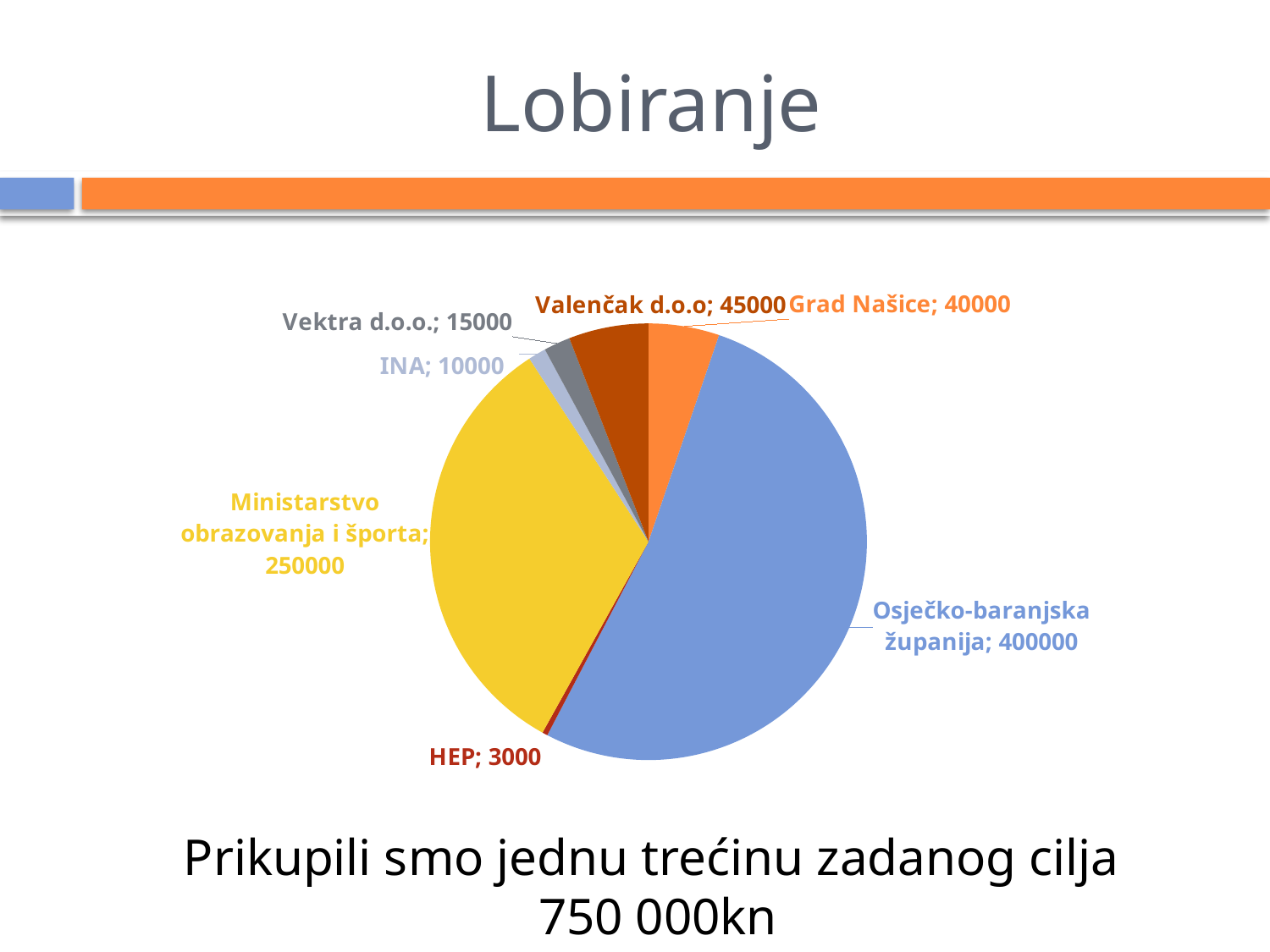
Which category has the largest slice of the pie? Osječko-baranjska županija What is the value for Valenčak d.o.o? 45000 What is the value for Ministarstvo obrazovanja i športa? 250000 How many slices does the pie chart have? 7 Which category has the smallest slice of the pie? HEP What is the sum of all the values shown in the pie chart? 763000 What kind of chart is shown on the slide? pie chart What is the value for Osječko-baranjska županija? 400000 What colour is the slice for Ministarstvo obrazovanja i športa? yellow What is the value for HEP? 3000 Which is larger, the value for Valenčak d.o.o or the value for Grad Našice? Valenčak d.o.o What is the difference between the values for Osječko-baranjska županija and Ministarstvo obrazovanja i športa? 150000